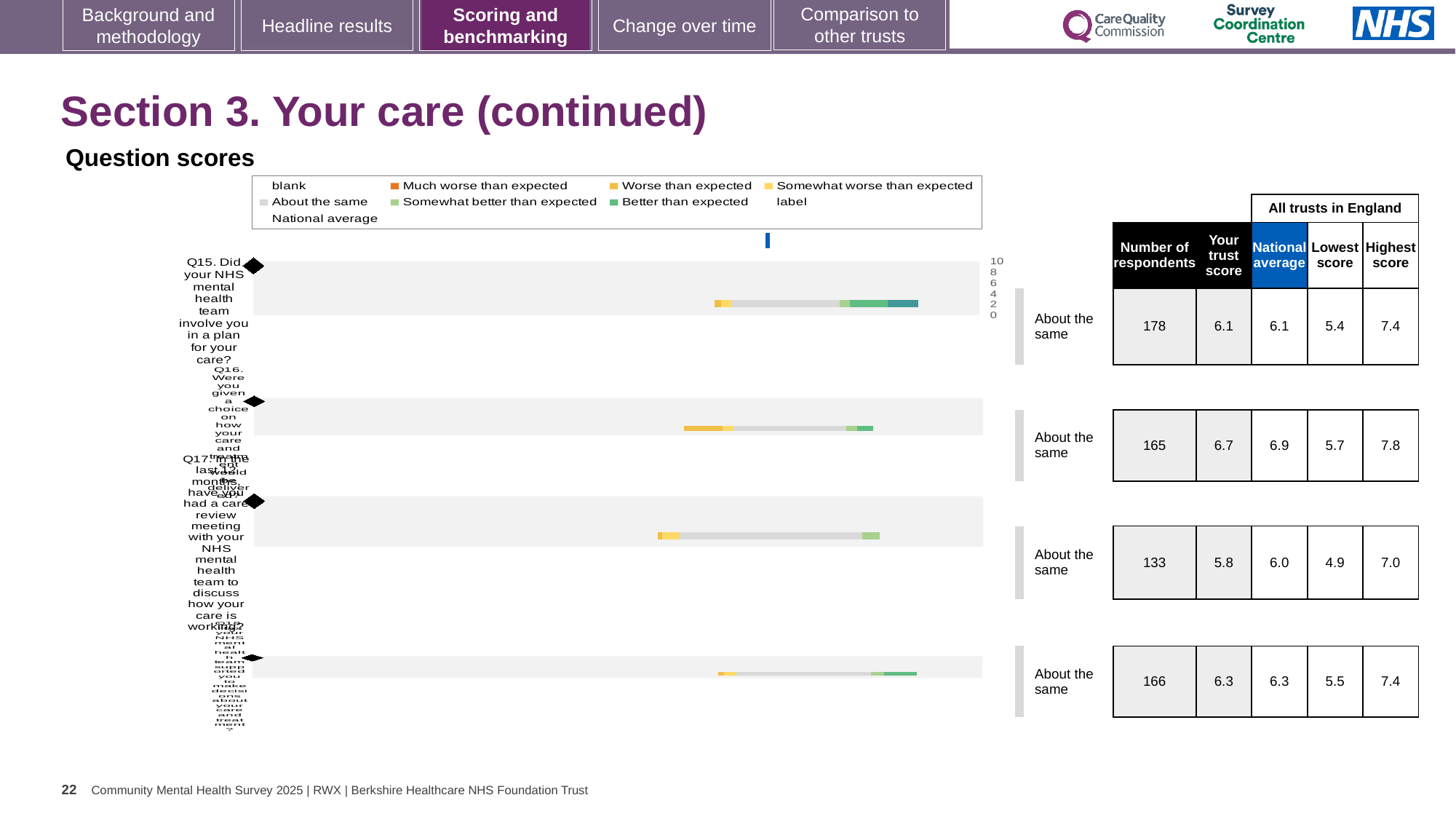
In the table beside the chart, what is the national average for Q17 (care review meeting in the last 12 months)? 6.0 In the table beside the chart, what is the lowest score among all trusts in England for Q17? 4.9 In the table beside the chart, what is the trust score for Q16 (Were you given a choice on how your care and treatment would be delivered)? 6.7 How many questions (bars) are plotted in the Question scores chart? 4 What is the difference between the highest score (7.8) and the lowest score (5.7) for Q16 in the table beside the chart? 2.1 Which question has the highest number of respondents in the table beside the chart? Q15 What benchmark category is shown next to each bar in the Question scores chart? About the same In the table beside the chart, what is the highest score among all trusts in England for Q16? 7.8 Which question has the lowest number of respondents in the table beside the chart? Q17 In the table beside the chart, how many respondents answered Q15 (Did your NHS mental health team involve you in a plan for your care?)? 178 What kind of chart is shown under 'Question scores'? bar chart For Q16, which is larger in the table beside the chart: the trust score or the national average? National average